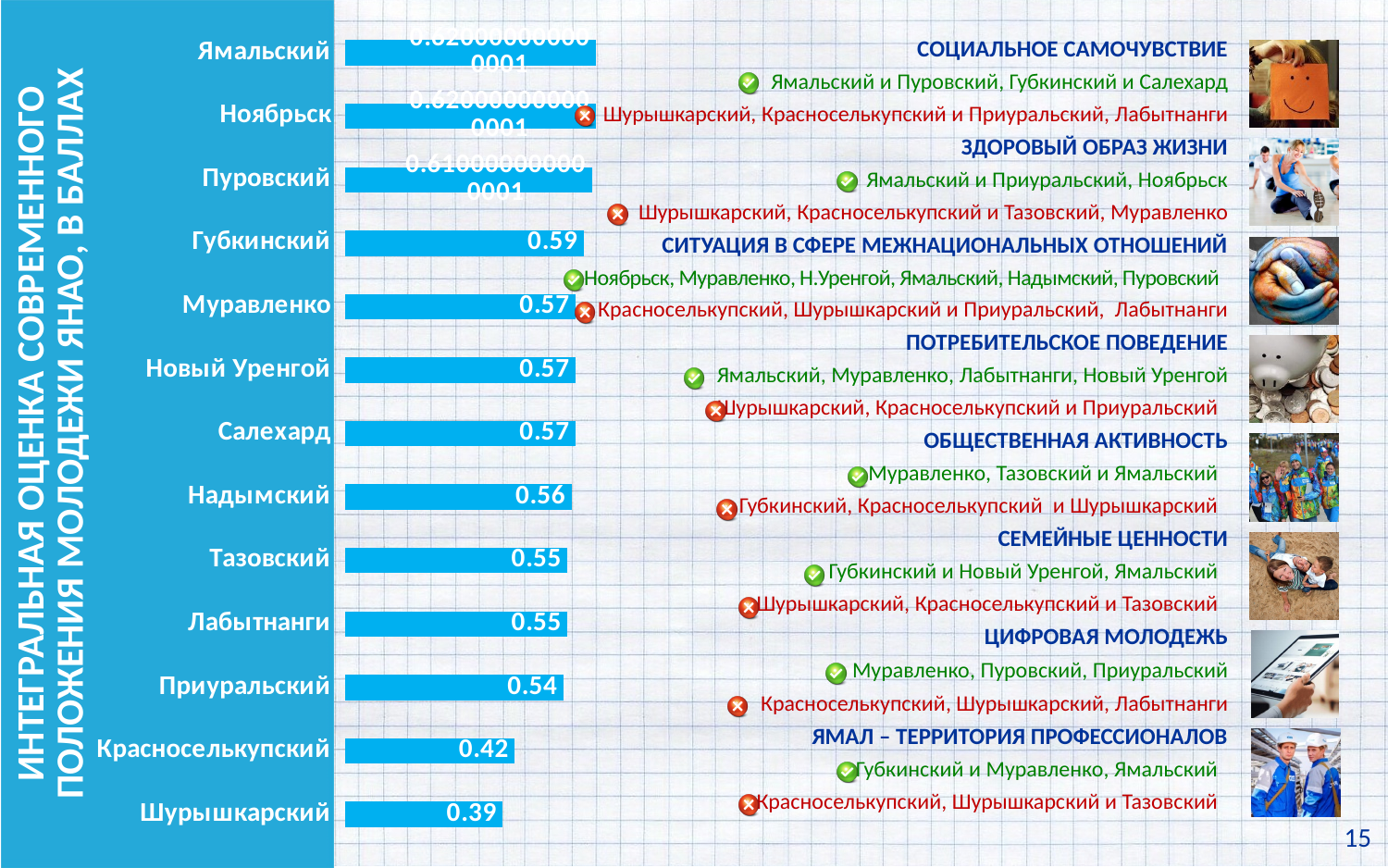
What is the difference between the values for Губкинский and Шурышкарский? 0.20 What is the value for Красноселькупский? 0.42 What is the value for Шурышкарский? 0.39 What is the value for Надымский? 0.56 What type of chart is shown on the slide? Bar chart Which has a larger value, Губкинский or Тазовский? Губкинский What is the value for Губкинский? 0.59 What is the difference between the values for Красноселькупский and Шурышкарский? 0.03 Which category has the lowest value in the bar chart? Шурышкарский What is the value for Приуральский? 0.54 How many categories (municipalities) are plotted in the bar chart? 13 Do the bar values increase or decrease going from the top category to the bottom category? Decrease